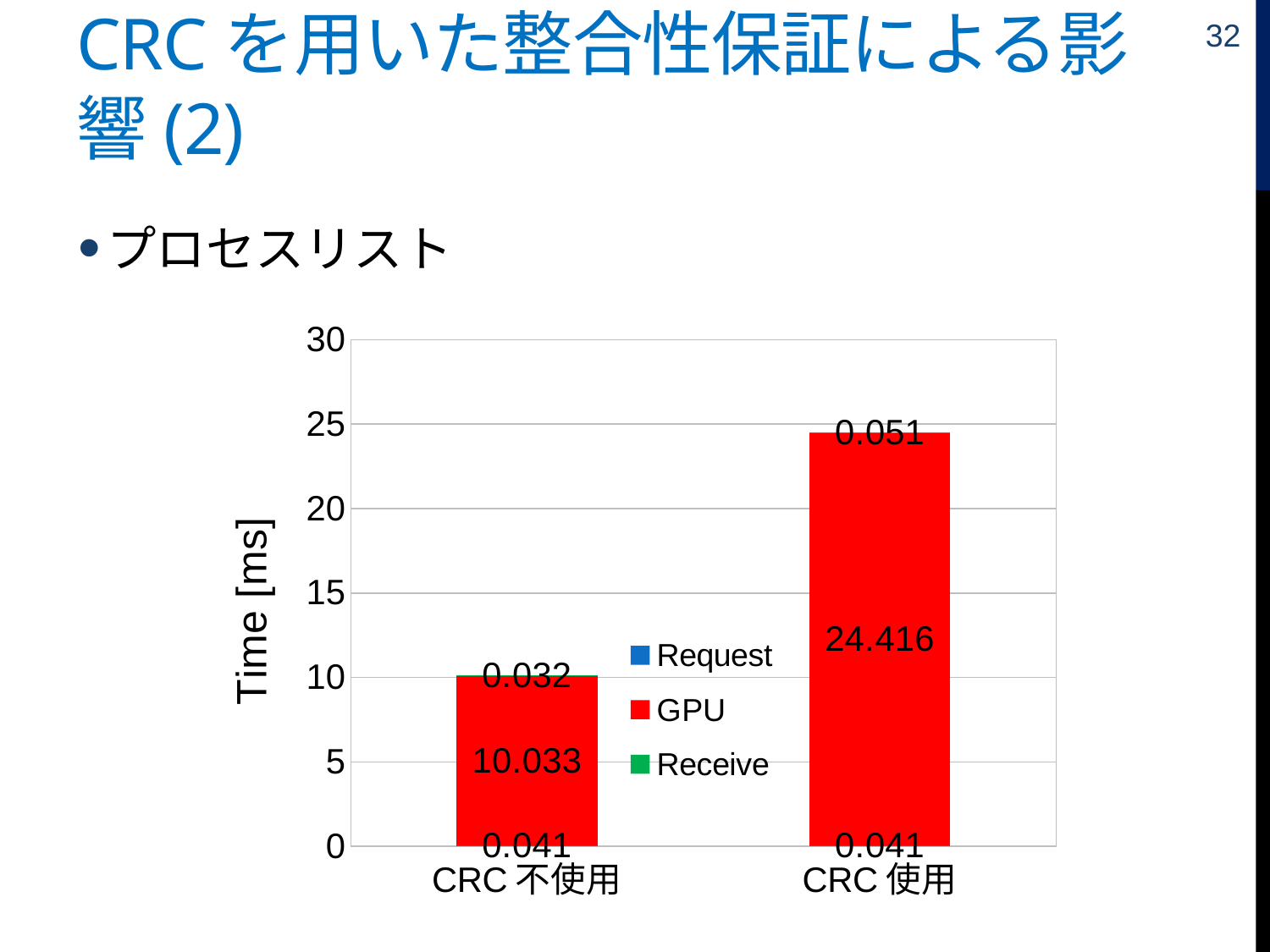
What is the Receive value for CRC 使用? 0.051 What is the label of the y axis? Time [ms] What is the Receive value for CRC 不使用? 0.032 What is the total of the stacked bar for CRC 不使用? 10.106 Which category has the higher GPU value, CRC 不使用 or CRC 使用? CRC 使用 What is the GPU value for CRC 不使用? 10.033 What is the difference between the GPU values for CRC 使用 and CRC 不使用? 14.383 How many series does the legend list? 3 What is the Request value for CRC 使用? 0.041 How many categories are shown on the x axis? 2 What is the GPU value for CRC 使用? 24.416 What is the total of the stacked bar for CRC 使用? 24.508